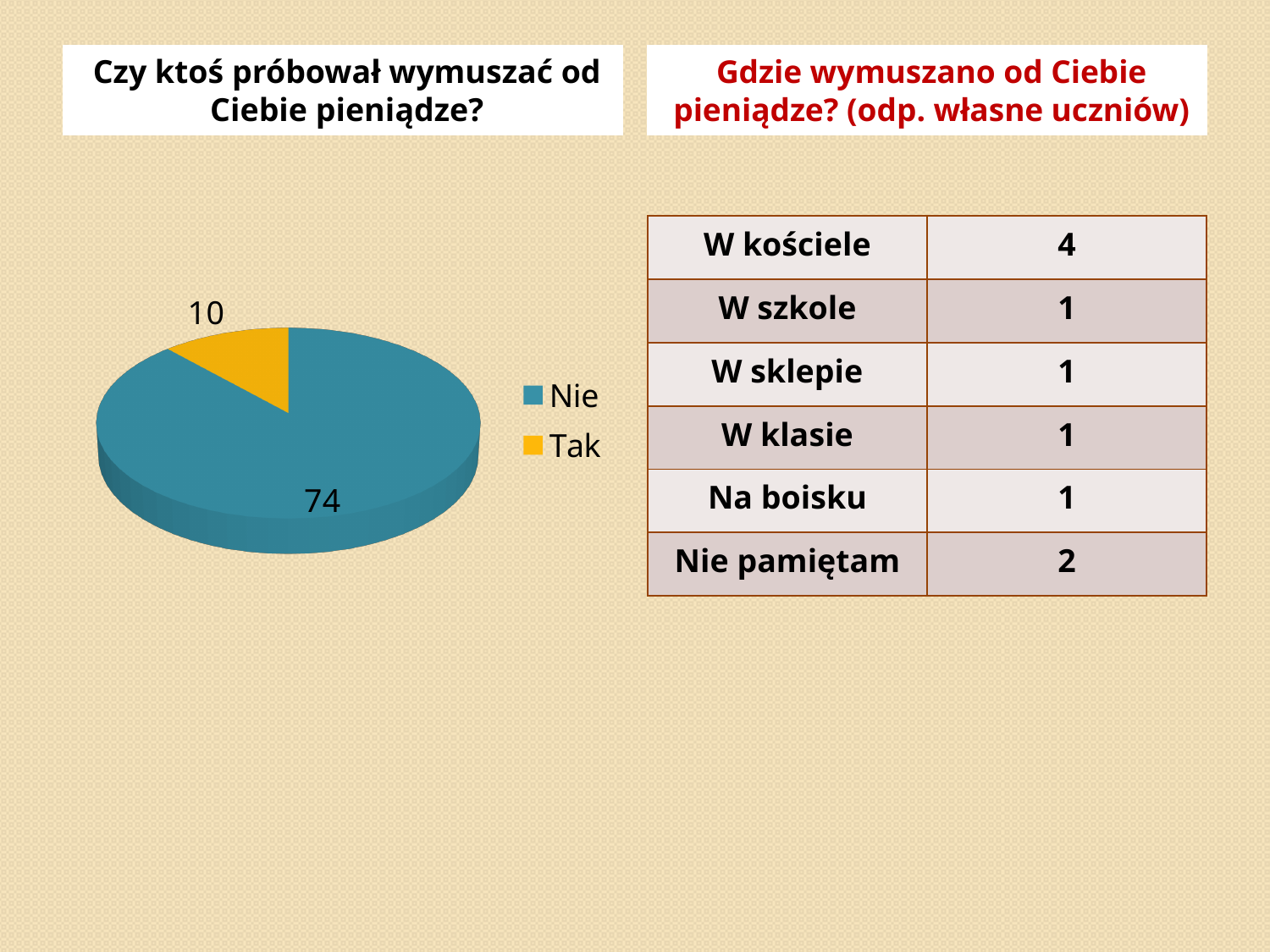
Which is larger in the pie chart, "Nie" or "Tak"? Nie What is the value for "Nie" in the pie chart? 74 What colour is the "Tak" slice in the pie chart? yellow How many entries does the pie chart's legend list? 2 What is the total of all slices in the pie chart? 84 How many slices does the pie chart have? 2 What is the difference between the "Nie" and "Tak" values in the pie chart? 64 Which slice of the pie chart is the smallest? Tak What type of chart is shown on the slide? pie chart What is the value for "Tak" in the pie chart? 10 What is the title of the pie chart? Czy ktoś próbował wymuszać od Ciebie pieniądze? Which slice of the pie chart is the largest? Nie